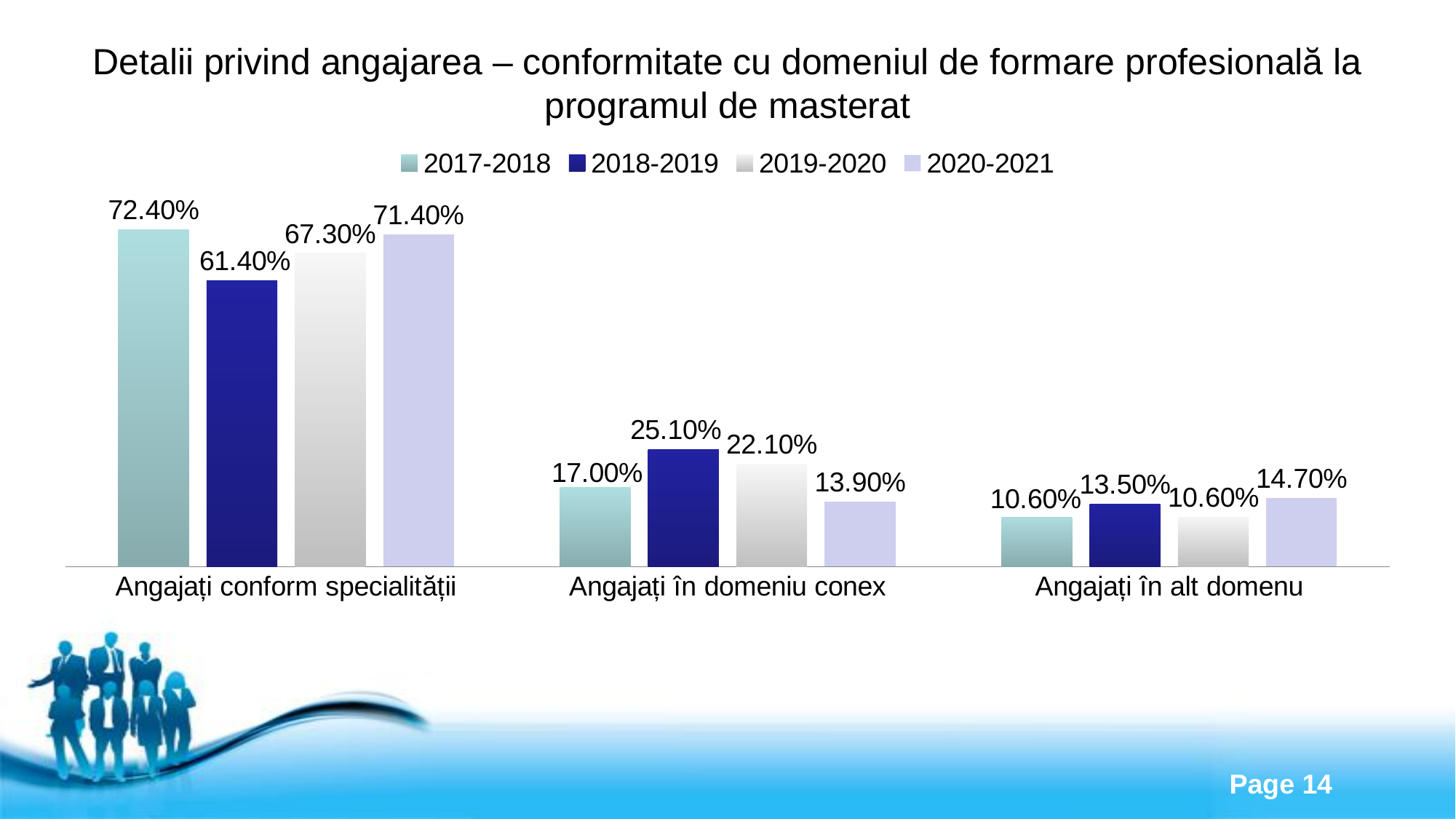
What is the value for 2018-2019 in the "Angajați în alt domenu" category? 13.50% What kind of chart is shown on the slide? Bar chart How many categories are shown on the x axis? 3 Which series has the lowest value in the "Angajați conform specialității" category? 2018-2019 What is the difference between the 2020-2021 and 2019-2020 values in the "Angajați în alt domenu" category? 4.10% How many series does the legend list? 4 Which is larger: the 2019-2020 value for "Angajați în domeniu conex" or the 2020-2021 value for "Angajați în alt domenu"? 2019-2020 value for Angajați în domeniu conex Which series is shown in dark blue in the legend? 2018-2019 What is the difference between the 2017-2018 and 2018-2019 values in the "Angajați conform specialității" category? 11.00% Which series has the highest value in the "Angajați în domeniu conex" category? 2018-2019 What is the value for 2017-2018 in the "Angajați conform specialității" category? 72.40% What is the value for 2020-2021 in the "Angajați în domeniu conex" category? 13.90%